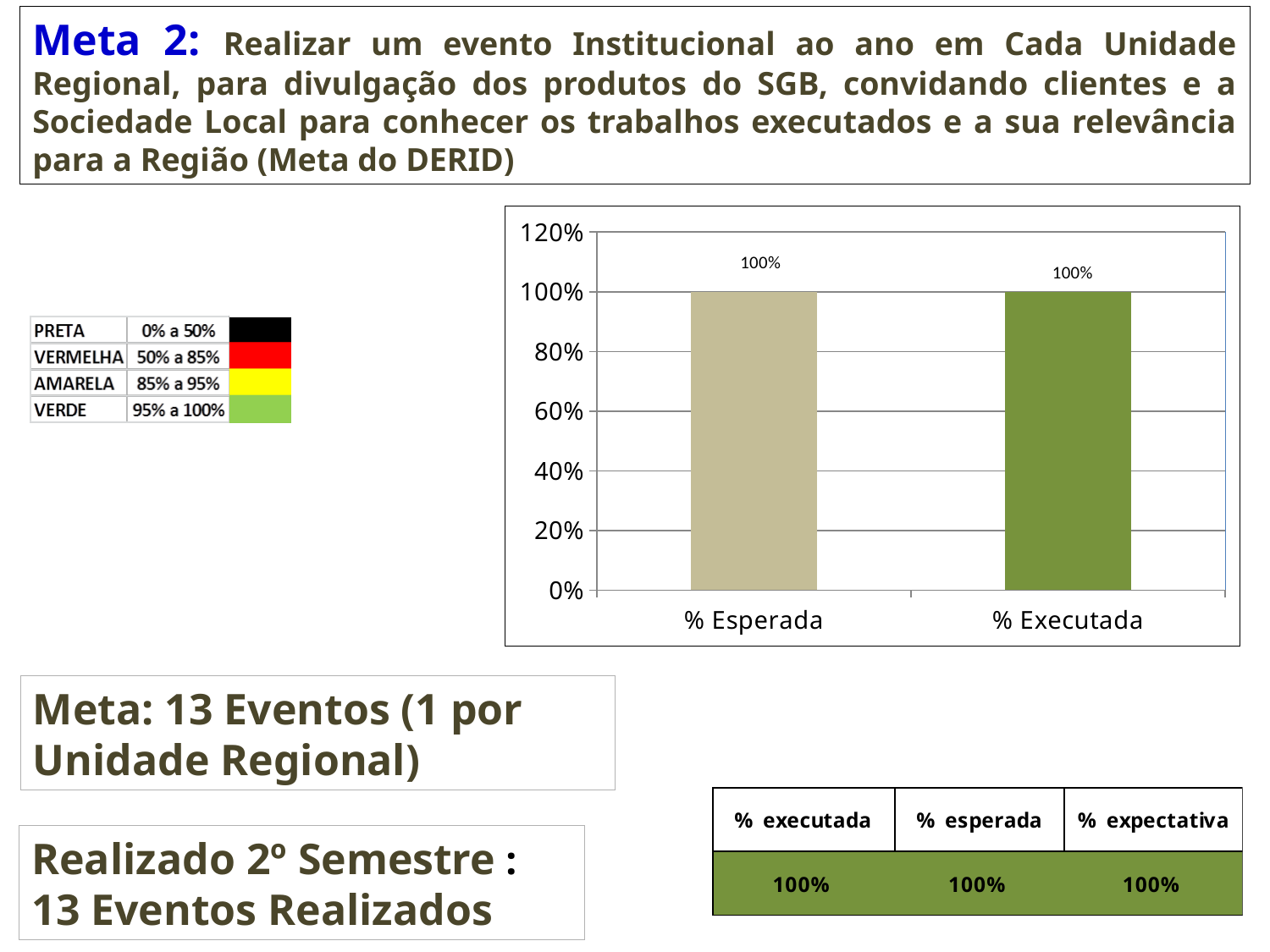
What is the value for % Esperada? 100% Is the value for % Esperada greater or less than 60%? greater What is the value for % Executada? 100% How many bars are plotted in the chart? 2 What kind of chart is shown on the slide? bar chart What is the highest value shown on the vertical axis of the chart? 120% What are the two category labels on the x axis of the chart? % Esperada and % Executada What colour is the % Executada bar? green Is the value for % Executada greater or less than 80%? greater What is the difference between the values for % Esperada and % Executada? 0%